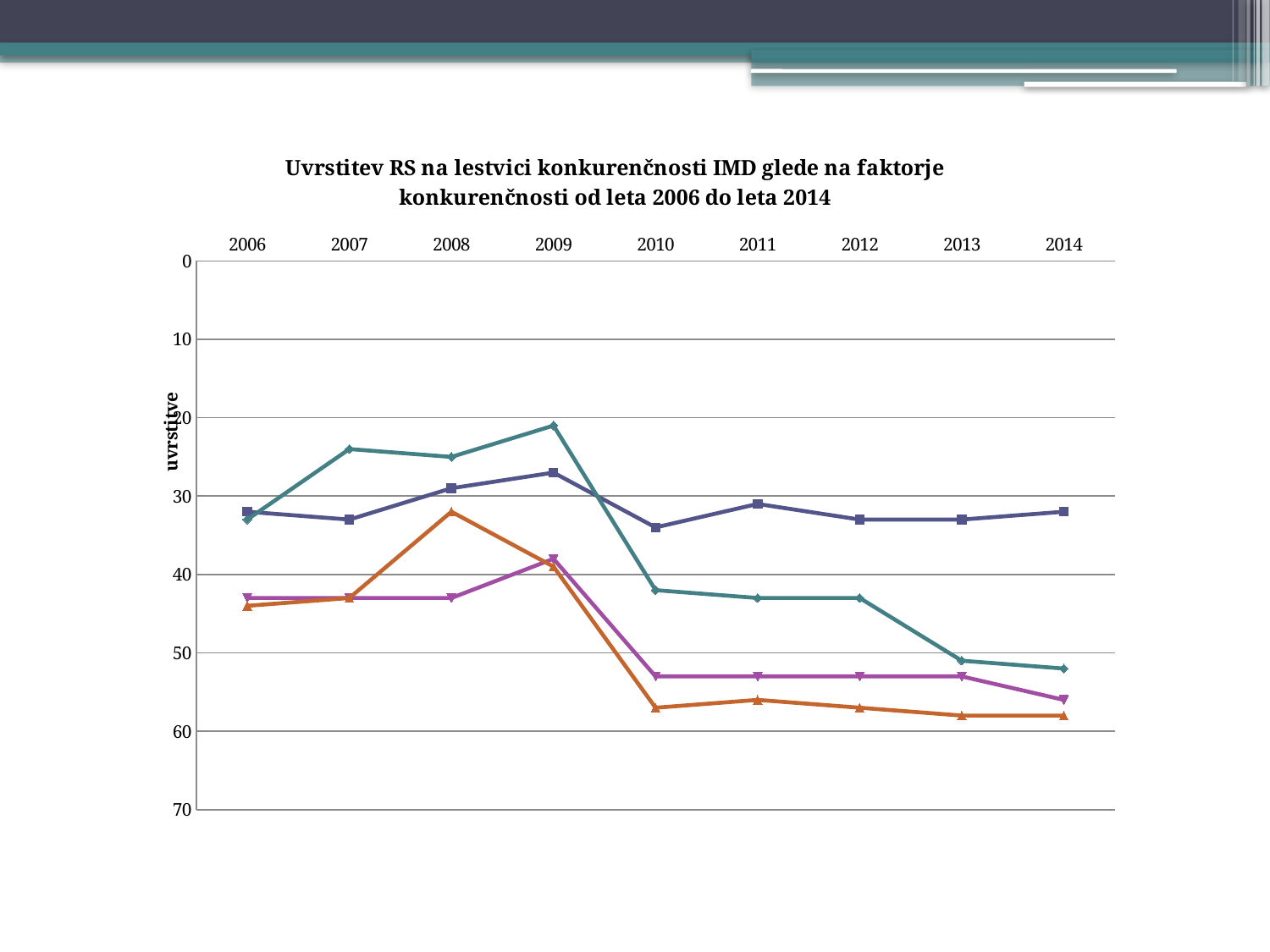
Is the value of the teal line with diamond markers in 2009 greater or less than 30? less Is the value of the dark blue line with square markers in 2010 greater or less than 30? greater Is the value of the teal line with diamond markers in 2012 greater or less than 40? greater In 2008, which has the larger value: the orange line with triangle markers or the purple line with inverted-triangle markers? the purple line What is the label on the vertical axis of the chart? uvrstitve Do the values of the teal line with diamond markers rise or fall from 2009 to 2014? rise What is the title of the chart? Uvrstitev RS na lestvici konkurenčnosti IMD glede na faktorje konkurenčnosti od leta 2006 do leta 2014 What kind of chart is shown on the slide? line chart How many years are shown along the x axis of the chart? 9 How many lines are plotted on the chart? 4